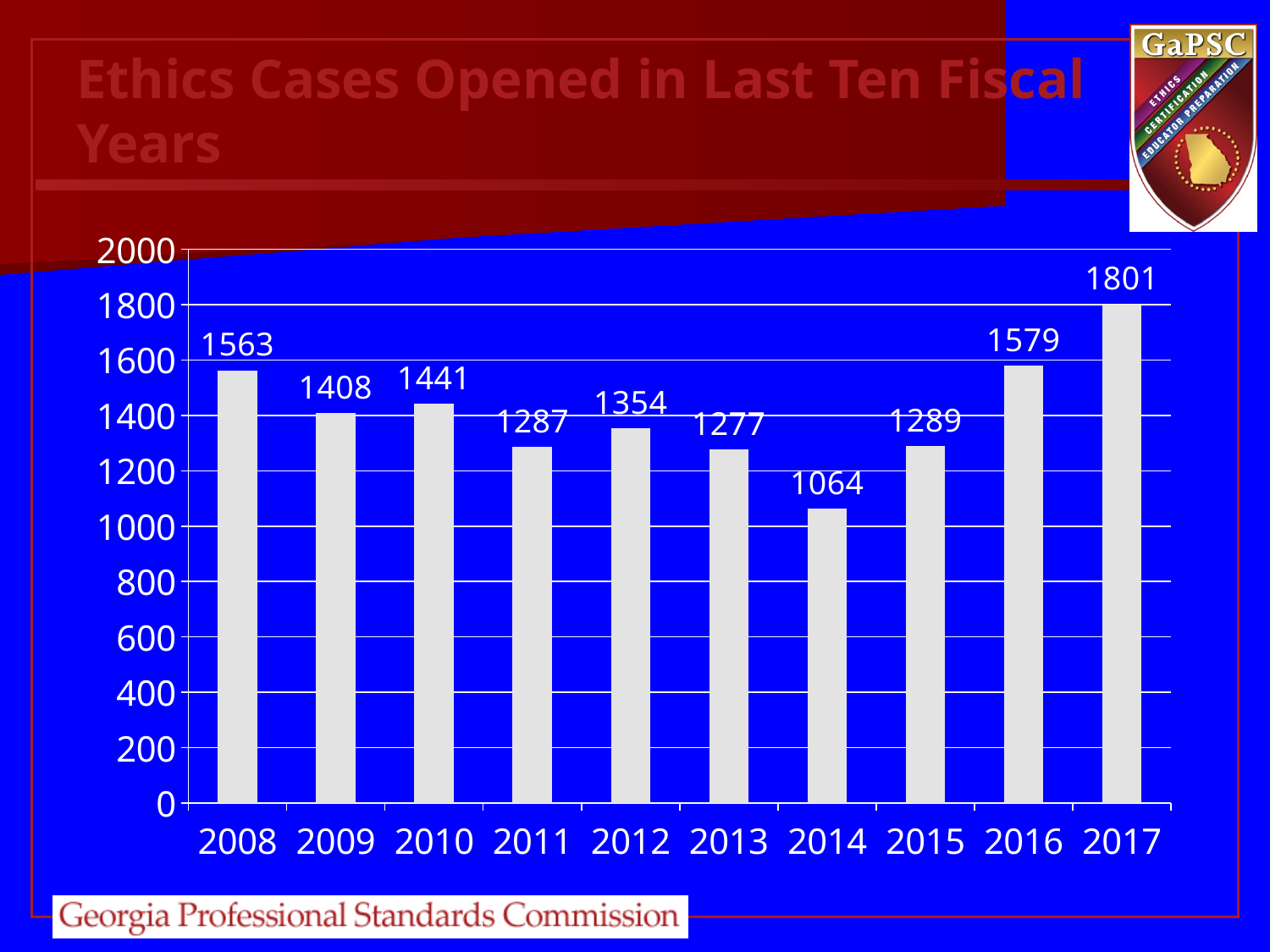
How many ethics cases were opened in 2008? 1563 What is the difference between the values for 2008 and 2014? 499 How many ethics cases were opened in 2017? 1801 What is the value shown for 2014? 1064 What is the difference between the values for 2017 and 2016? 222 What is the title of the slide? Ethics Cases Opened in Last Ten Fiscal Years What kind of chart is shown on the slide? Bar chart Which year has the highest number of ethics cases opened? 2017 Is the value for 2015 greater or less than 1200? greater How many years are shown on the x axis? 10 Which year has the lowest number of ethics cases opened? 2014 Which year has a larger value, 2010 or 2012? 2010